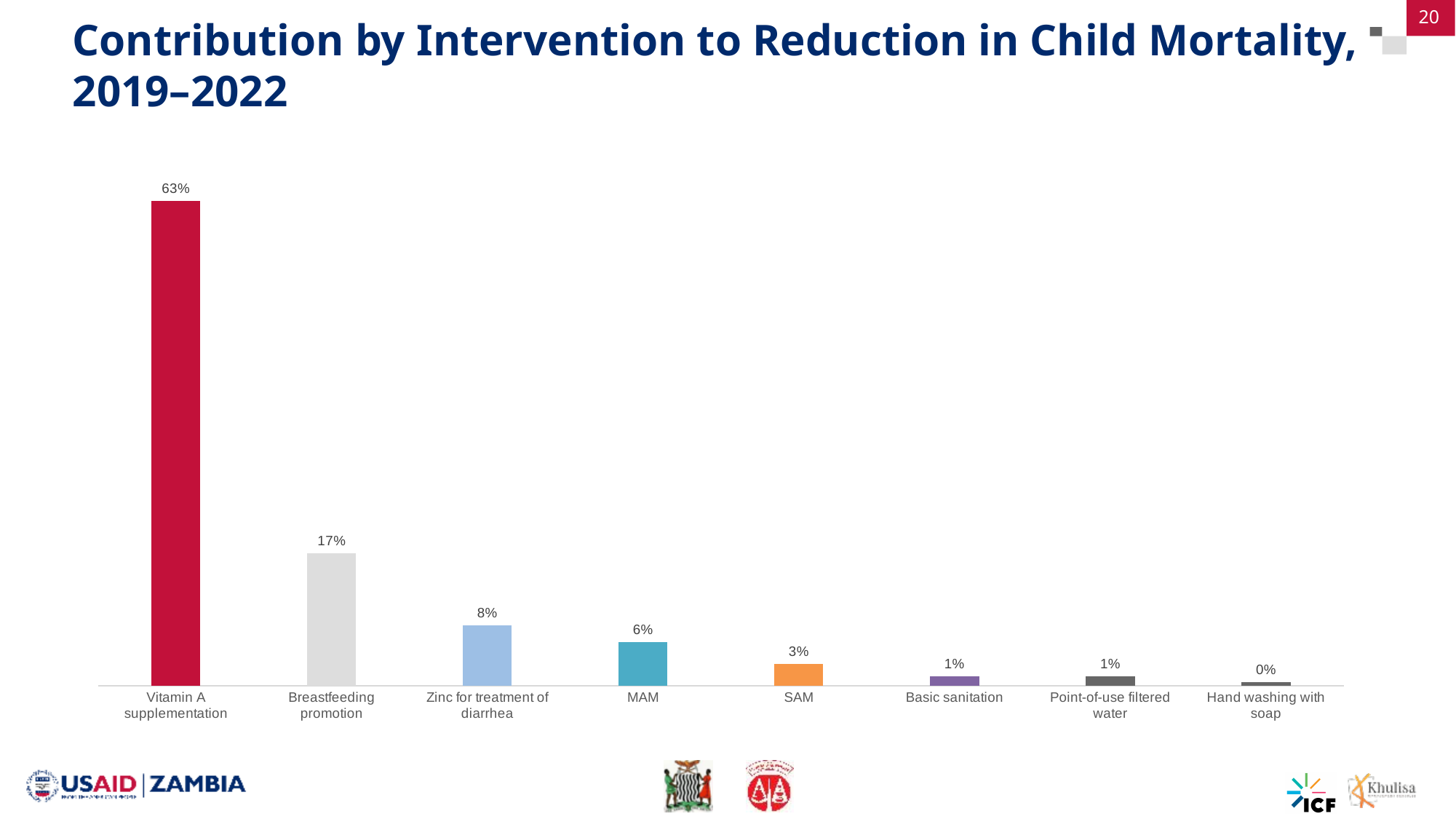
What kind of chart is shown on the slide? Bar chart Which has a larger value, MAM or SAM? MAM How many interventions are shown on the chart? 8 Which intervention has the highest contribution? Vitamin A supplementation What is the value shown for Breastfeeding promotion? 17% What is the difference between the values for Zinc for treatment of diarrhea and MAM? 2% What is the value shown for Zinc for treatment of diarrhea? 8% Which intervention has the lowest contribution? Hand washing with soap What is the title of the slide? Contribution by Intervention to Reduction in Child Mortality, 2019–2022 What is the difference between the values for Vitamin A supplementation and Breastfeeding promotion? 46% What is the contribution of Vitamin A supplementation to the reduction in child mortality? 63% What is the value shown for SAM? 3%